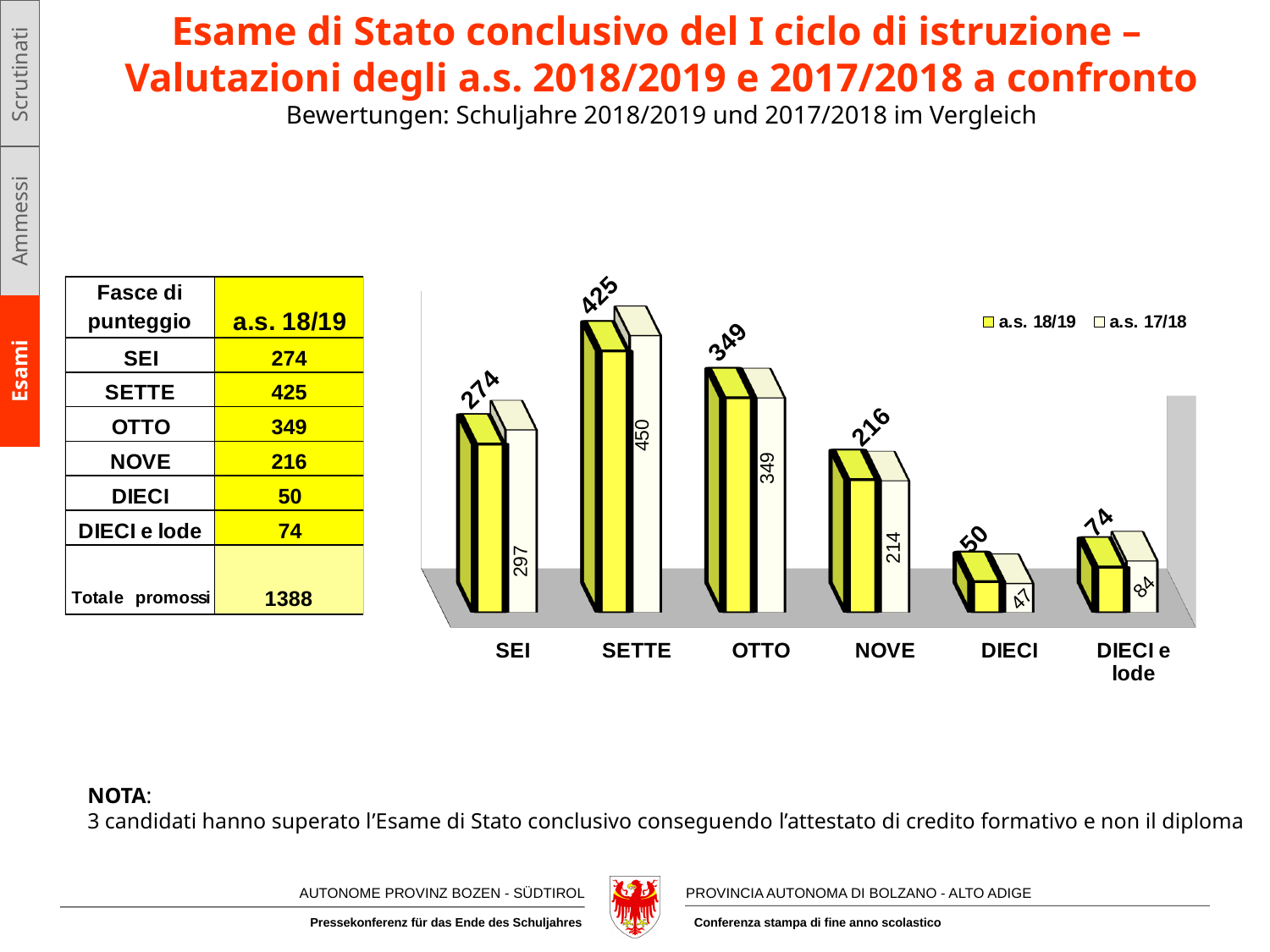
What is the value for SETTE in the a.s. 18/19 series? 425 How many series does the chart legend list? 2 Which category has the lowest value in the a.s. 17/18 series? DIECI What is the value for DIECI e lode in the a.s. 17/18 series? 84 What are the two series names listed in the chart legend? a.s. 18/19 and a.s. 17/18 What is the difference between the a.s. 17/18 and a.s. 18/19 values for SETTE? 25 Which category has the highest value in the a.s. 18/19 series? SETTE What kind of chart is shown on the slide? bar chart How many categories are shown on the x axis of the chart? 6 What is the value for SEI in the a.s. 17/18 series? 297 What is the value for NOVE in the a.s. 18/19 series? 216 Which is larger for SEI: the a.s. 18/19 value or the a.s. 17/18 value? a.s. 17/18